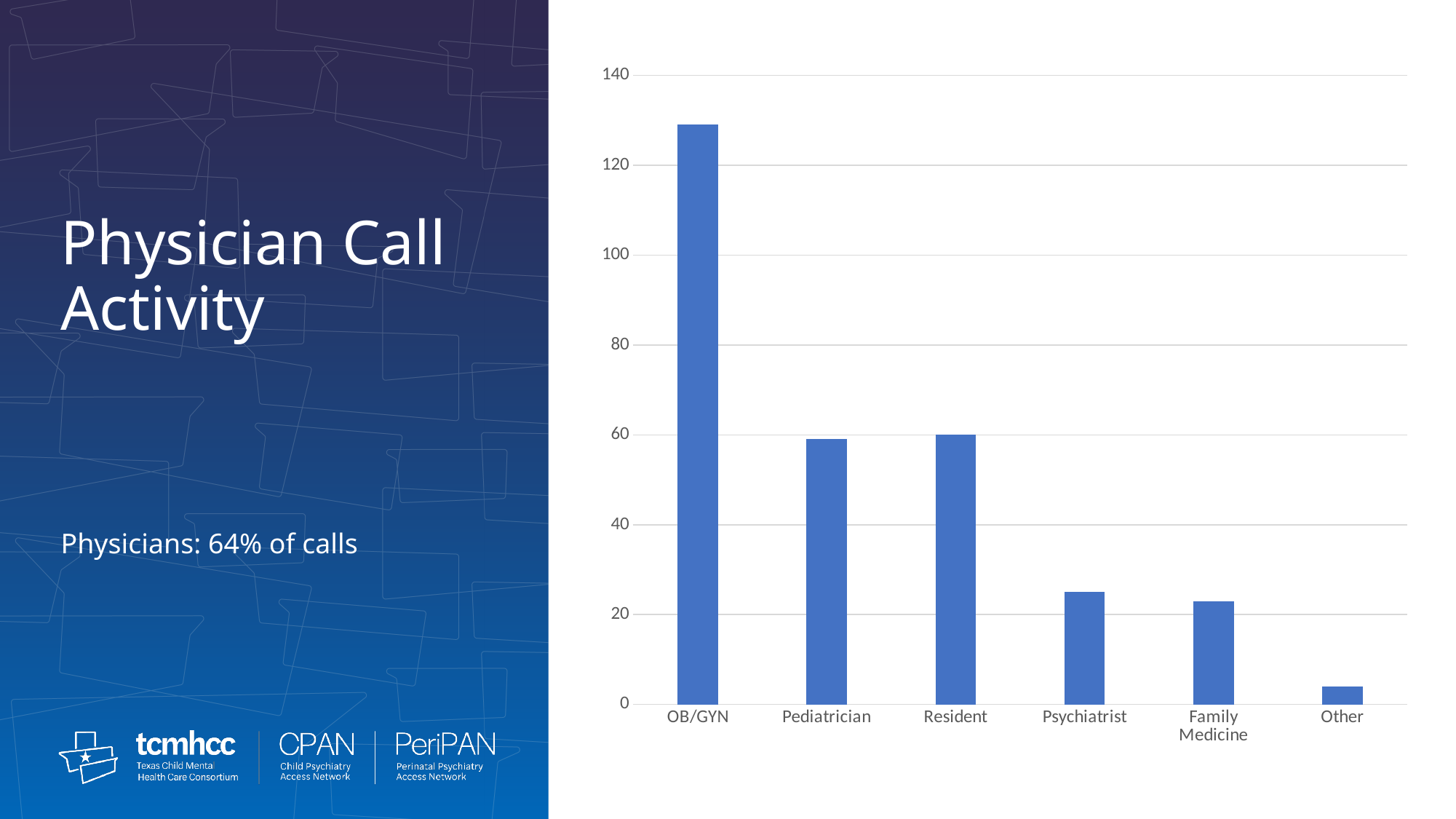
Which category has the highest value in the chart? OB/GYN Is the value for Other greater or less than 20? less What kind of chart is shown on the slide? bar chart Is the value for Resident greater or less than 40? greater How many categories are shown on the x axis of the chart? 6 Is the value for OB/GYN greater or less than 120? greater What is the title of the slide that contains the chart? Physician Call Activity Which is larger, the value for Psychiatrist or the value for Other? Psychiatrist Which is larger, the value for OB/GYN or the value for Pediatrician? OB/GYN Which category has the lowest value in the chart? Other